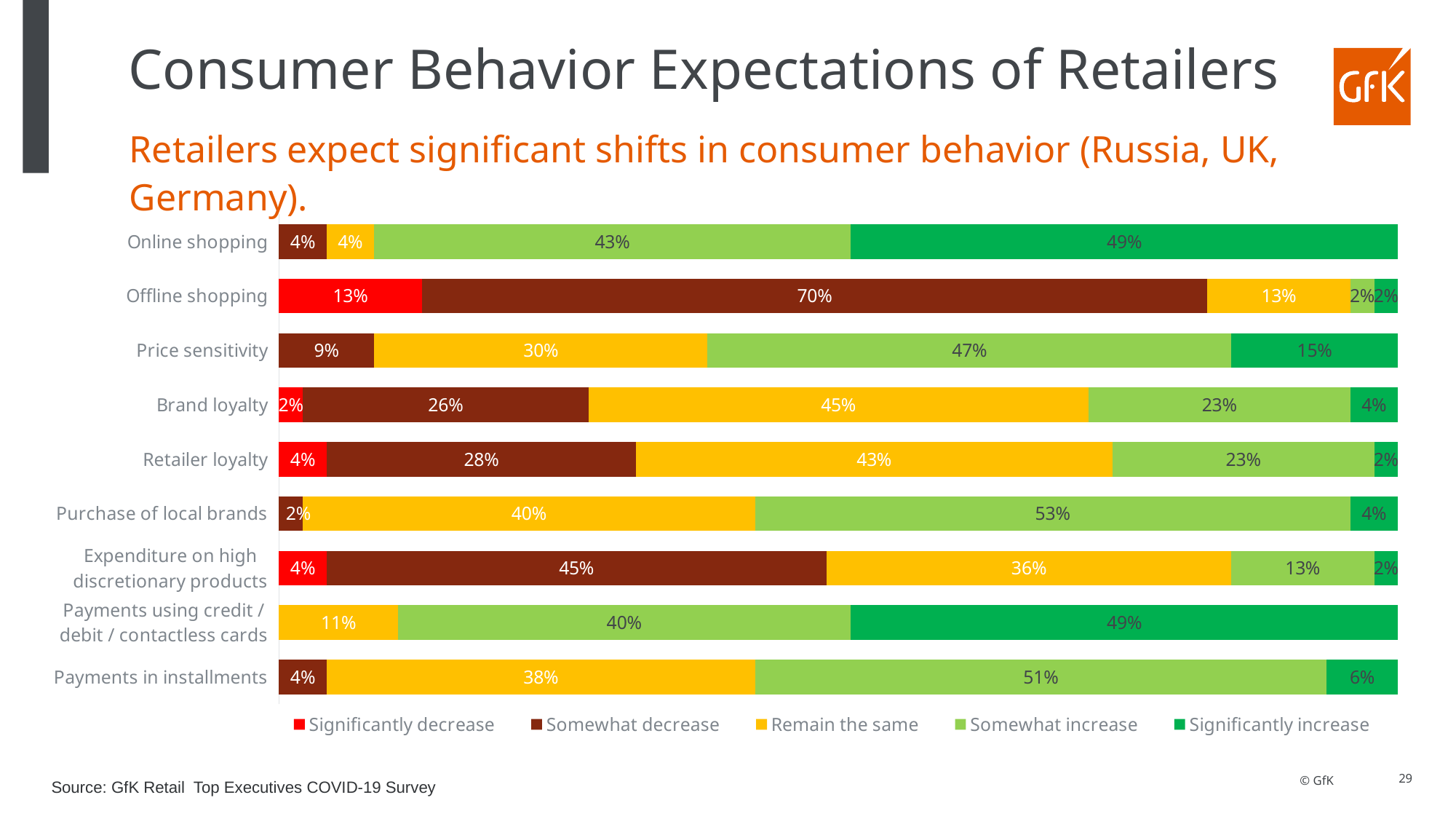
What is the total of the stacked bar for Payments in installments? 99% What is the 'Somewhat increase' value for Purchase of local brands? 53% What share of retailers expect price sensitivity to remain the same? 30% How many categories are shown on the chart? 9 How many series does the legend list? 5 Which category has the highest 'Significantly decrease' value? Offline shopping Which is larger: the 'Remain the same' value for Brand loyalty or for Retailer loyalty? Brand loyalty What kind of chart is shown on the slide? Stacked bar chart What percentage of retailers expect online shopping to significantly increase? 49% Which category has the highest 'Somewhat decrease' value? Offline shopping What is the 'Somewhat decrease' value for Offline shopping? 70% What is the difference between the 'Somewhat increase' and 'Significantly increase' values for Price sensitivity? 32%